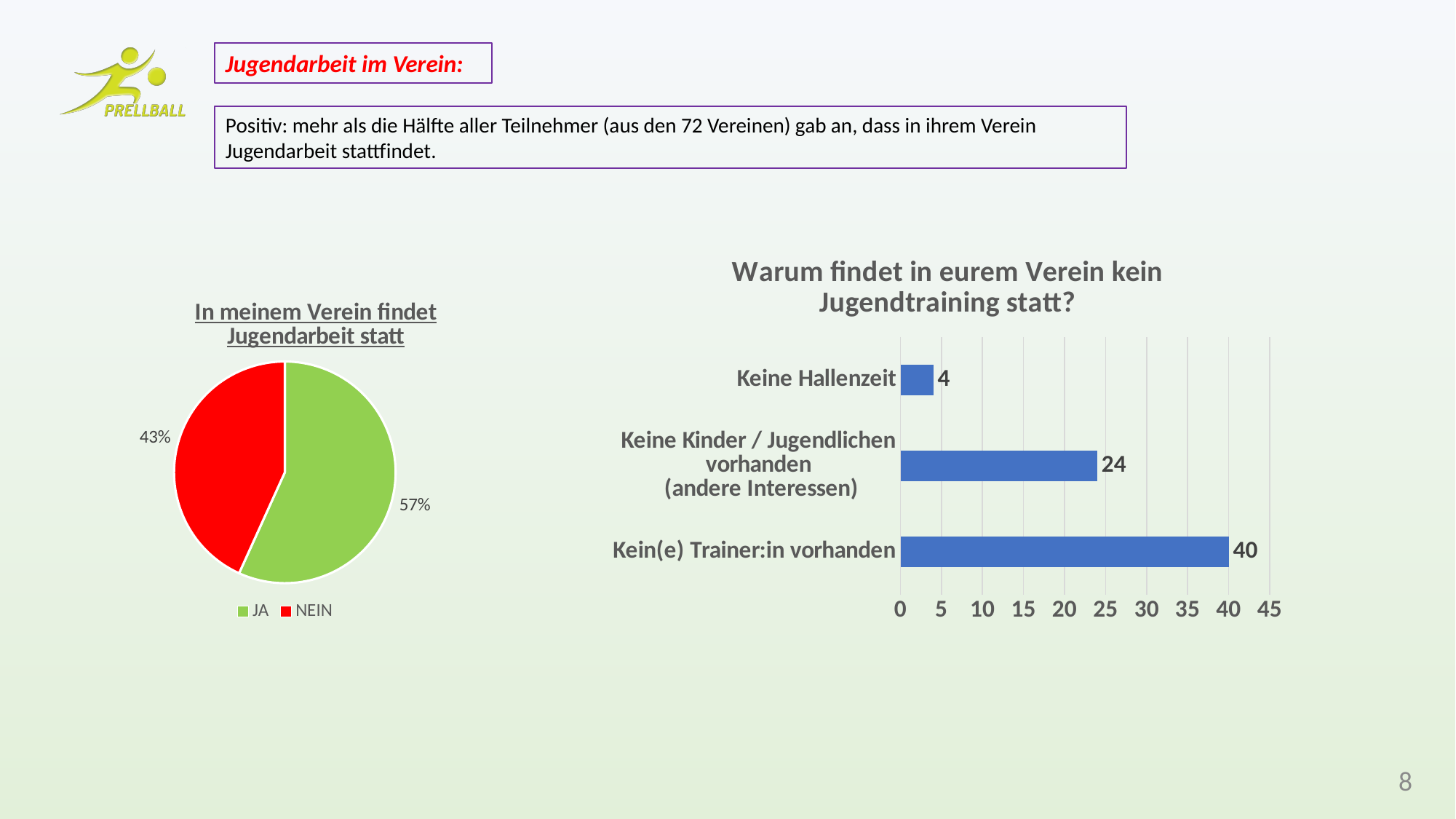
In the pie chart 'In meinem Verein findet Jugendarbeit statt', which slice is larger, JA or NEIN? JA In the chart 'Warum findet in eurem Verein kein Jugendtraining statt?', what is the value for Kein(e) Trainer:in vorhanden? 40 In the pie chart 'In meinem Verein findet Jugendarbeit statt', what share is labelled JA? 57% In the chart 'Warum findet in eurem Verein kein Jugendtraining statt?', what is the difference between Kein(e) Trainer:in vorhanden and Keine Kinder / Jugendlichen vorhanden (andere Interessen)? 16 In the chart 'Warum findet in eurem Verein kein Jugendtraining statt?', what is the value for Keine Hallenzeit? 4 In the pie chart 'In meinem Verein findet Jugendarbeit statt', what colour is the JA slice? Green What kind of chart is 'Warum findet in eurem Verein kein Jugendtraining statt?'? Bar chart In the pie chart 'In meinem Verein findet Jugendarbeit statt', how many entries does the legend list? 2 In the chart 'Warum findet in eurem Verein kein Jugendtraining statt?', what is the value for Keine Kinder / Jugendlichen vorhanden (andere Interessen)? 24 In the chart 'Warum findet in eurem Verein kein Jugendtraining statt?', which category has the highest value? Kein(e) Trainer:in vorhanden In the pie chart 'In meinem Verein findet Jugendarbeit statt', what share is labelled NEIN? 43% In the chart 'Warum findet in eurem Verein kein Jugendtraining statt?', which category has the lowest value? Keine Hallenzeit